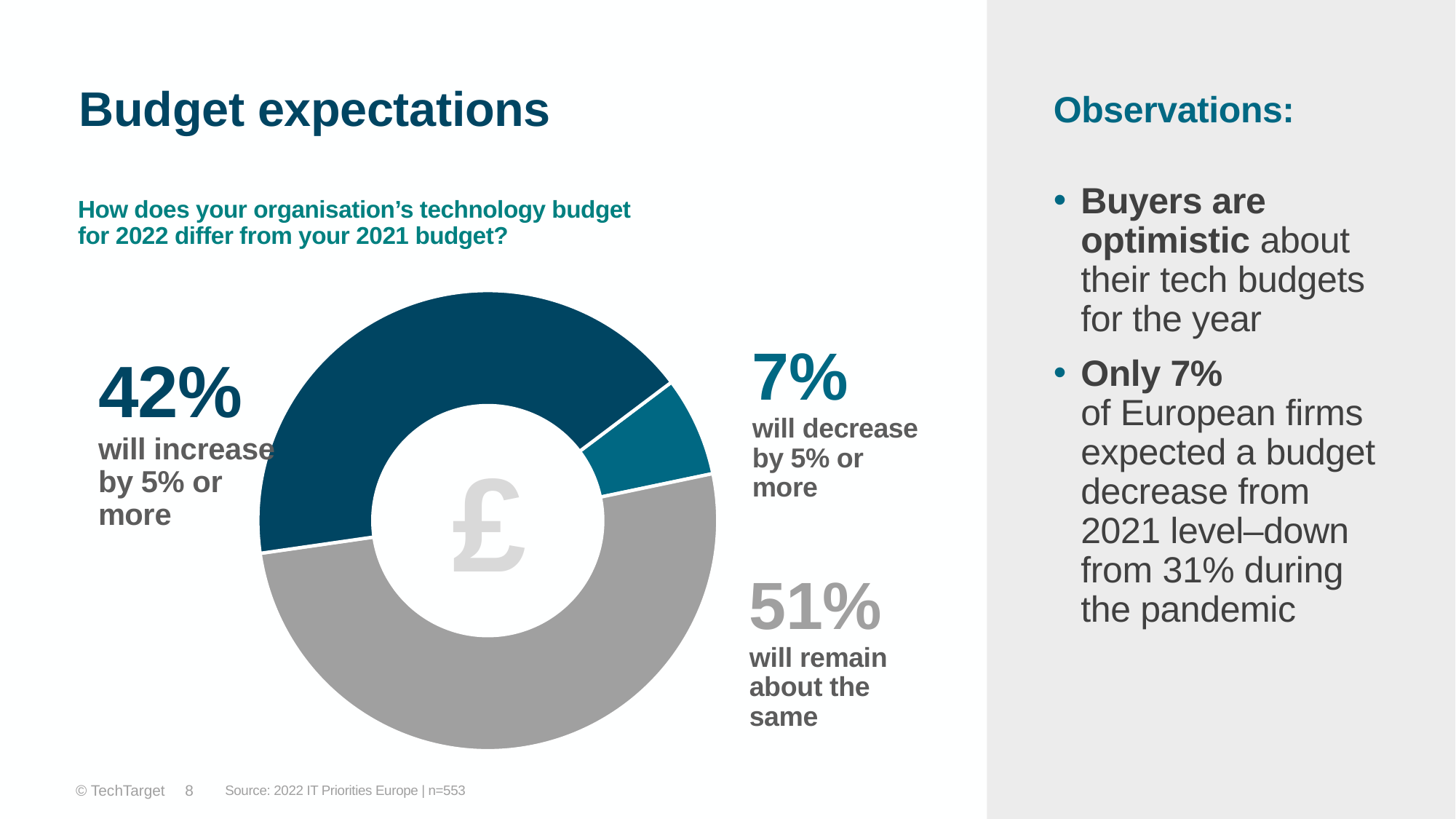
What percentage of respondents say their technology budget will remain about the same? 51% Which response has the largest share of the chart? will remain about the same What percentage of respondents say their technology budget will increase by 5% or more? 42% What kind of chart is shown on the slide? Doughnut (pie) chart What symbol appears in the centre of the doughnut chart? £ Which response has the smallest share of the chart? will decrease by 5% or more What is the difference in percentage points between those who say the budget will remain about the same and those who say it will increase by 5% or more? 9 Which is larger: the share that will increase by 5% or more, or the share that will decrease by 5% or more? will increase by 5% or more What is the difference in percentage points between those who say the budget will increase by 5% or more and those who say it will decrease by 5% or more? 35 What survey question does the chart answer? How does your organisation's technology budget for 2022 differ from your 2021 budget? How many response categories are shown in the chart? 3 What percentage of respondents say their technology budget will decrease by 5% or more? 7%